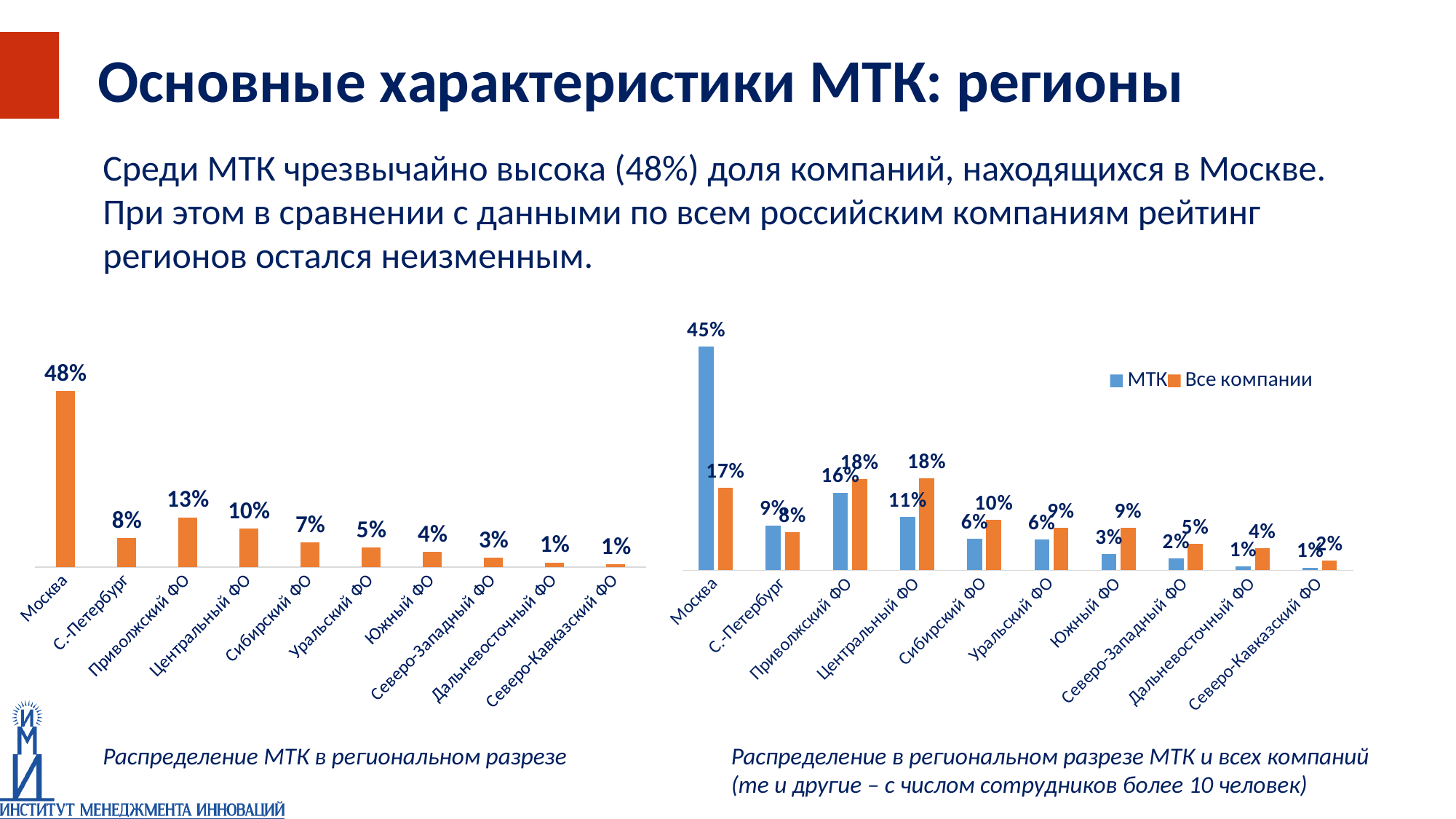
In the left chart, what is the value for Приволжский ФО? 13% In the right chart, how many series does the legend list? 2 In the left chart, do the values generally rise or fall from left to right after Москва? fall In the right chart, what is the difference between the МТК and Все компании values for Москва? 28% What type of chart is the right chart? bar chart In the left chart, which region has the highest value? Москва In the left chart (Распределение МТК в региональном разрезе), what is the value for Москва? 48% In the right chart, what is the Все компании value for Центральный ФО? 18% In the right chart, which is larger for Южный ФО: МТК or Все компании? Все компании In the left chart, how many regions are shown on the x axis? 10 In the left chart, what is the difference between the values for Москва and С.-Петербург? 40% In the right chart, what is the МТК value for Москва? 45%